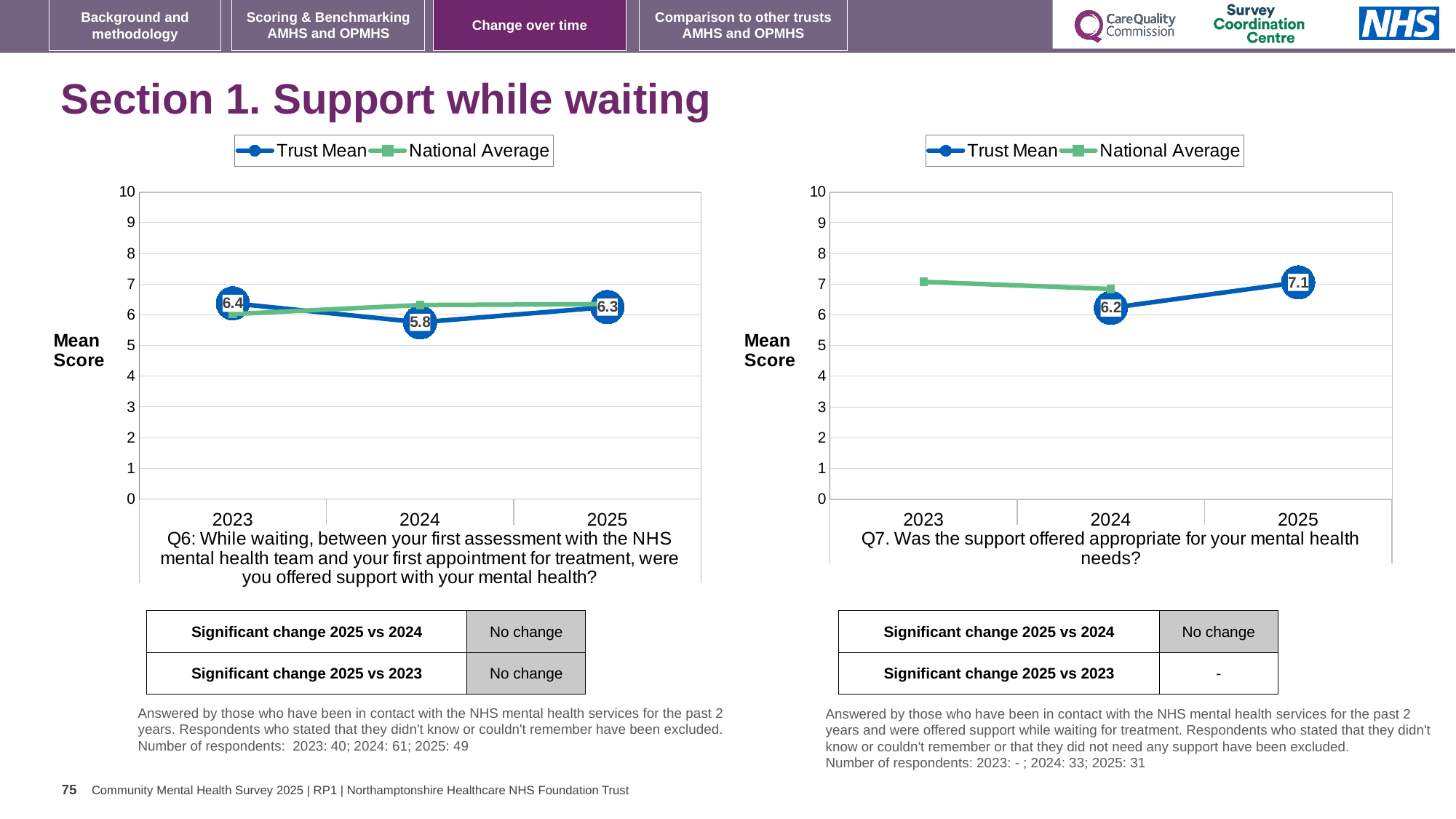
In the right chart (Q7), what is the Trust Mean score for 2024? 6.2 In the right chart (Q7), what is the difference between the Trust Mean scores for 2025 and 2024? 0.9 In the left chart (Q6), what is the difference between the Trust Mean scores for 2023 and 2024? 0.6 In the left chart (Q6), which year has the highest Trust Mean score? 2023 How many series does the legend of the left chart (Q6) list? 2 In the left chart (Q6), which year has the lowest Trust Mean score? 2024 In the right chart (Q7), what is the Trust Mean score for 2025? 7.1 In the right chart (Q7), is the National Average value for 2023 greater or less than 6? greater In the left chart (Q6), what is the Trust Mean score for 2024? 5.8 In the left chart (Q6), what is the Trust Mean score for 2023? 6.4 In the right chart (Q7), is the Trust Mean score for 2025 greater or less than the Trust Mean score for 2024? greater What type of chart is used for Q7 on the right of the slide? Line chart